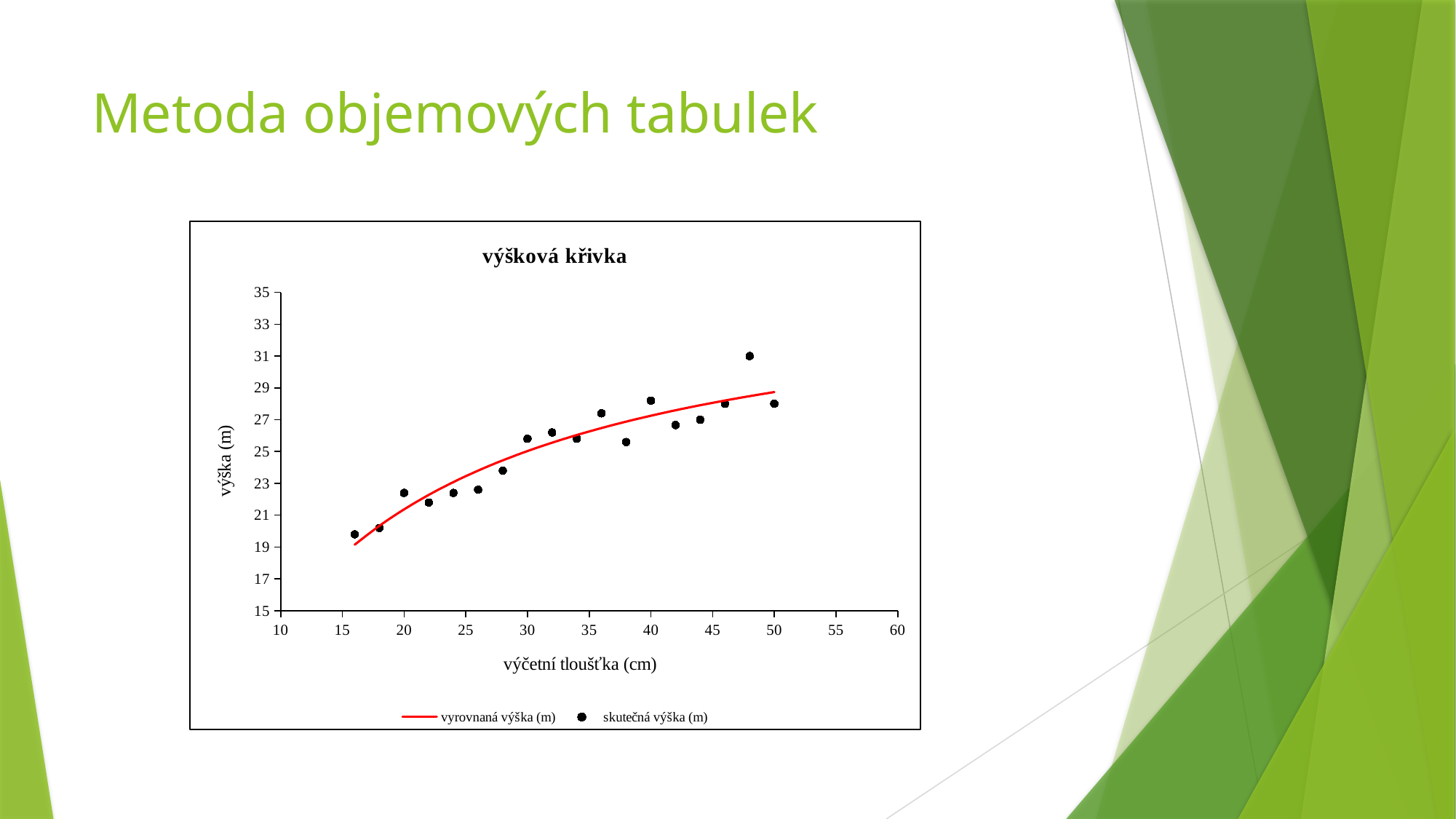
How many data points of skutečná výška (m) are plotted? 18 Is the skutečná výška (m) at výčetní tloušťka 16 cm greater or less than 21? less Is the skutečná výška (m) at výčetní tloušťka 38 cm greater or less than 27? less What type of chart is shown on the slide? scatter chart What are the two series named in the legend? vyrovnaná výška (m) and skutečná výška (m) How many series does the legend list? 2 What is the title of the chart? výšková křivka Is the skutečná výška (m) at výčetní tloušťka 48 cm greater or less than 29? greater At which výčetní tloušťka (cm) is the skutečná výška (m) highest? 48 Which has the larger skutečná výška (m): výčetní tloušťka 48 cm or 50 cm? 48 cm Does the skutečná výška (m) generally rise or fall as výčetní tloušťka (cm) increases? rise At which výčetní tloušťka (cm) is the skutečná výška (m) lowest? 16